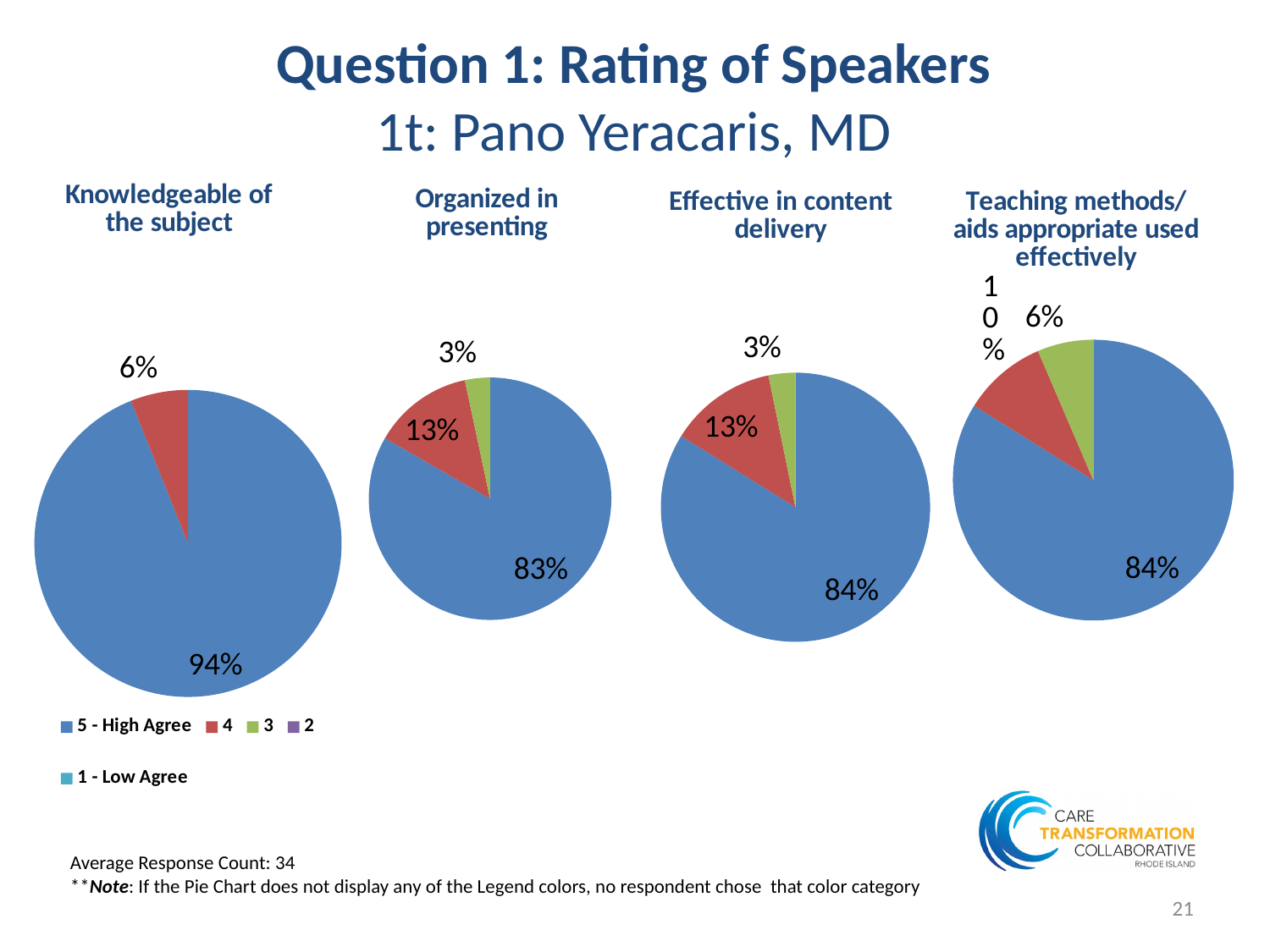
In the 'Teaching methods/aids appropriate used effectively' pie chart, which rating has the smallest slice? 3 How many slices does the 'Knowledgeable of the subject' pie chart have? 2 Which is larger: the '5 - High Agree' share in the 'Knowledgeable of the subject' chart or in the 'Organized in presenting' chart? Knowledgeable of the subject In the 'Effective in content delivery' pie chart, what percentage is shown for the rating '4'? 13% In the 'Organized in presenting' pie chart, what share of respondents chose '5 - High Agree'? 83% In the 'Organized in presenting' pie chart, what percentage is shown for the rating '3'? 3% In the 'Organized in presenting' pie chart, what is the difference in percentage points between the '5 - High Agree' slice and the '4' slice? 70 In the 'Effective in content delivery' pie chart, which rating has the largest slice? 5 - High Agree In the 'Knowledgeable of the subject' pie chart, what percentage is shown for the rating '4'? 6% How many entries does the legend list for the pie charts? 5 In the 'Teaching methods/aids appropriate used effectively' pie chart, what percentage is shown for the rating '4'? 10% In the 'Knowledgeable of the subject' pie chart, what share of respondents chose '5 - High Agree'? 94%